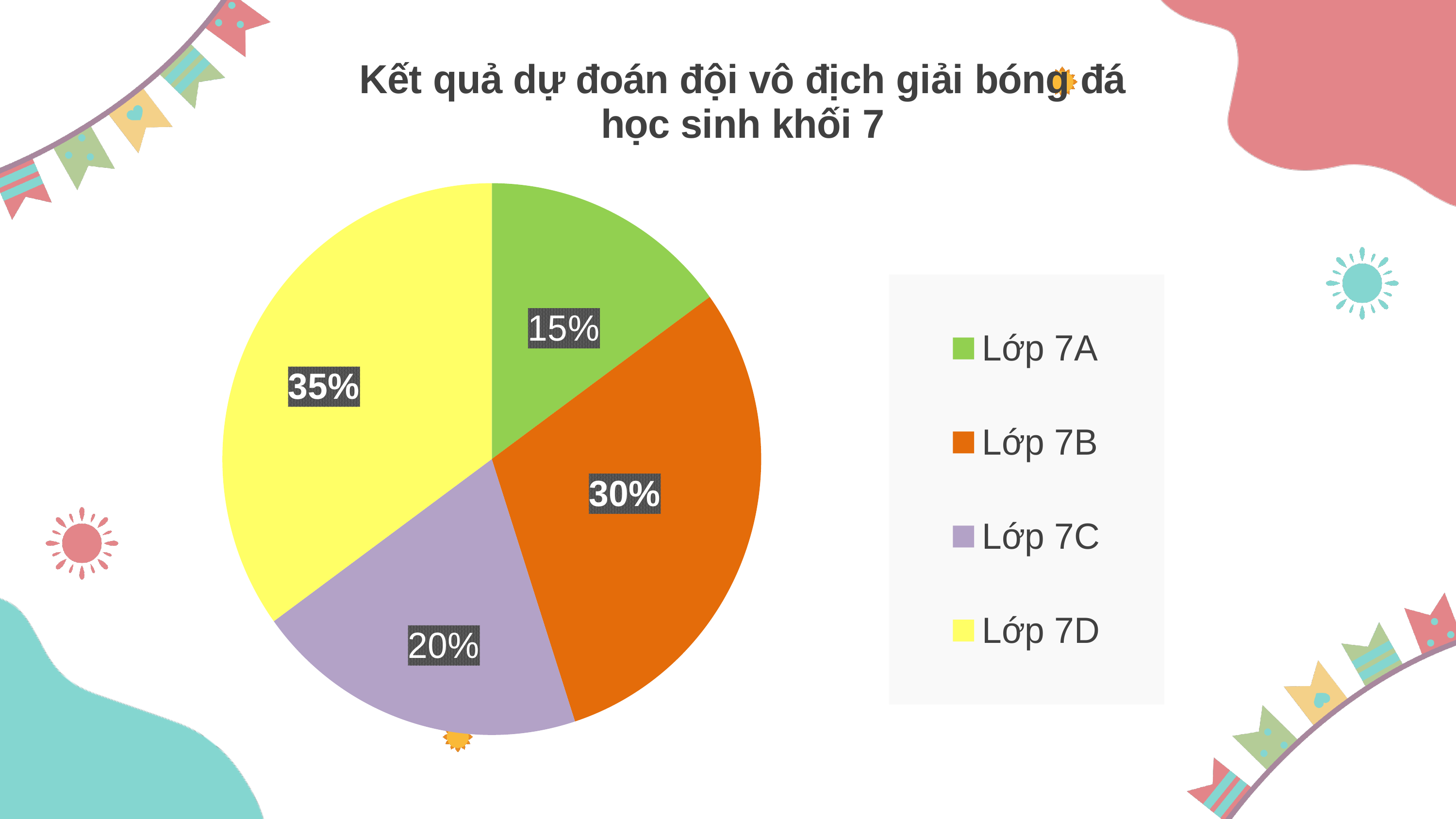
What type of chart is shown on the slide? pie chart What is the combined share of Lớp 7A and Lớp 7C? 35% What colour is the slice for Lớp 7B? orange Which has a larger share, Lớp 7B or Lớp 7C? Lớp 7B What percentage of the pie is Lớp 7D? 35% Which class has the smallest share of the pie? Lớp 7A What percentage of the pie is Lớp 7C? 20% Which class has the largest share of the pie? Lớp 7D How many slices does the pie chart have? 4 What percentage of the pie is Lớp 7B? 30% What is the difference in percentage points between Lớp 7D and Lớp 7A? 20 What percentage of the pie is Lớp 7A? 15%